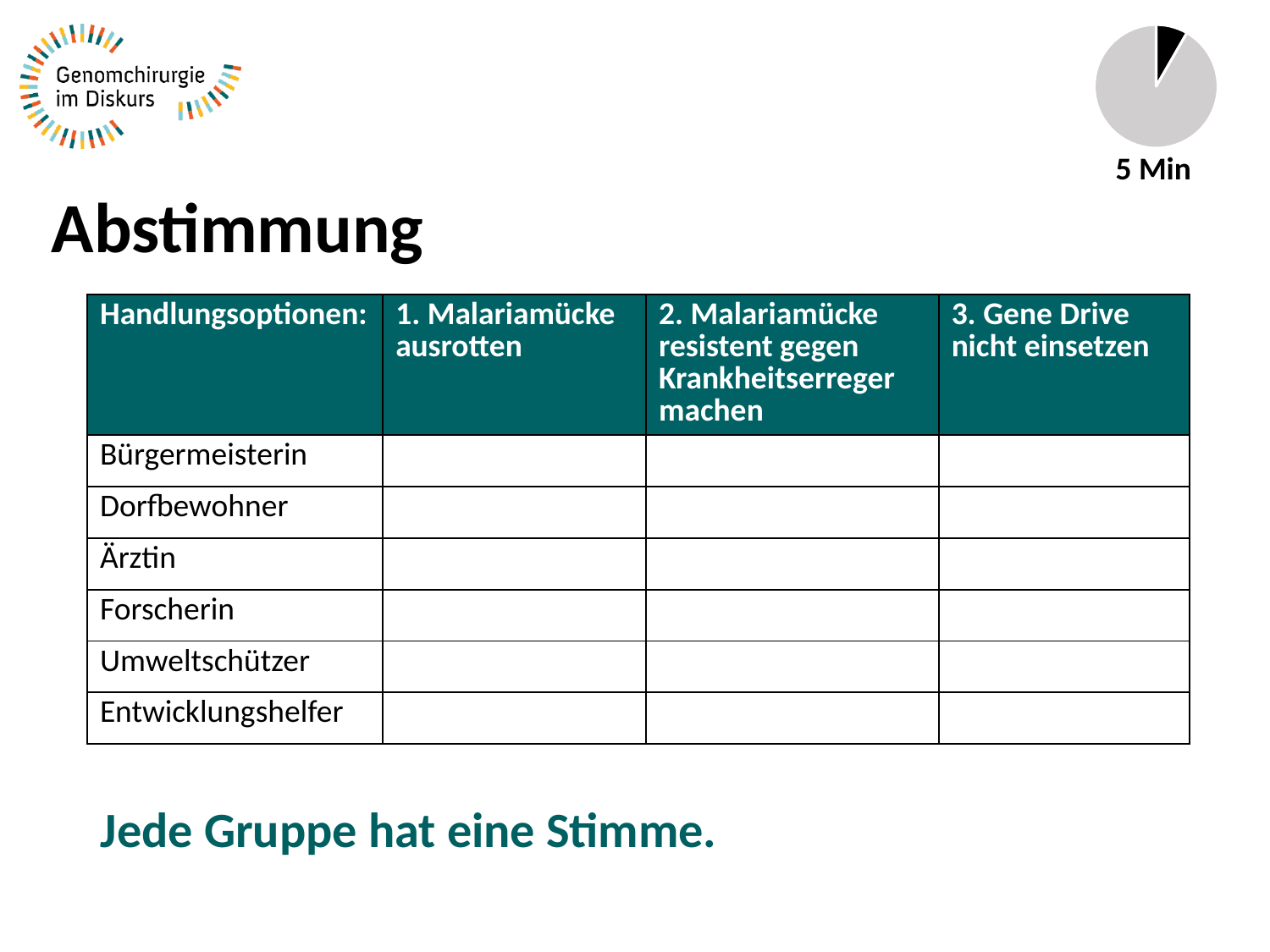
What colour is the small slice of the pie chart in the top right corner? black In the pie chart in the top right corner, which slice is larger, the grey one or the black one? the grey one What kind of chart is shown in the top right corner of the slide? pie chart What label is printed below the pie chart in the top right corner? 5 Min How many slices does the pie chart in the top right corner have? 2